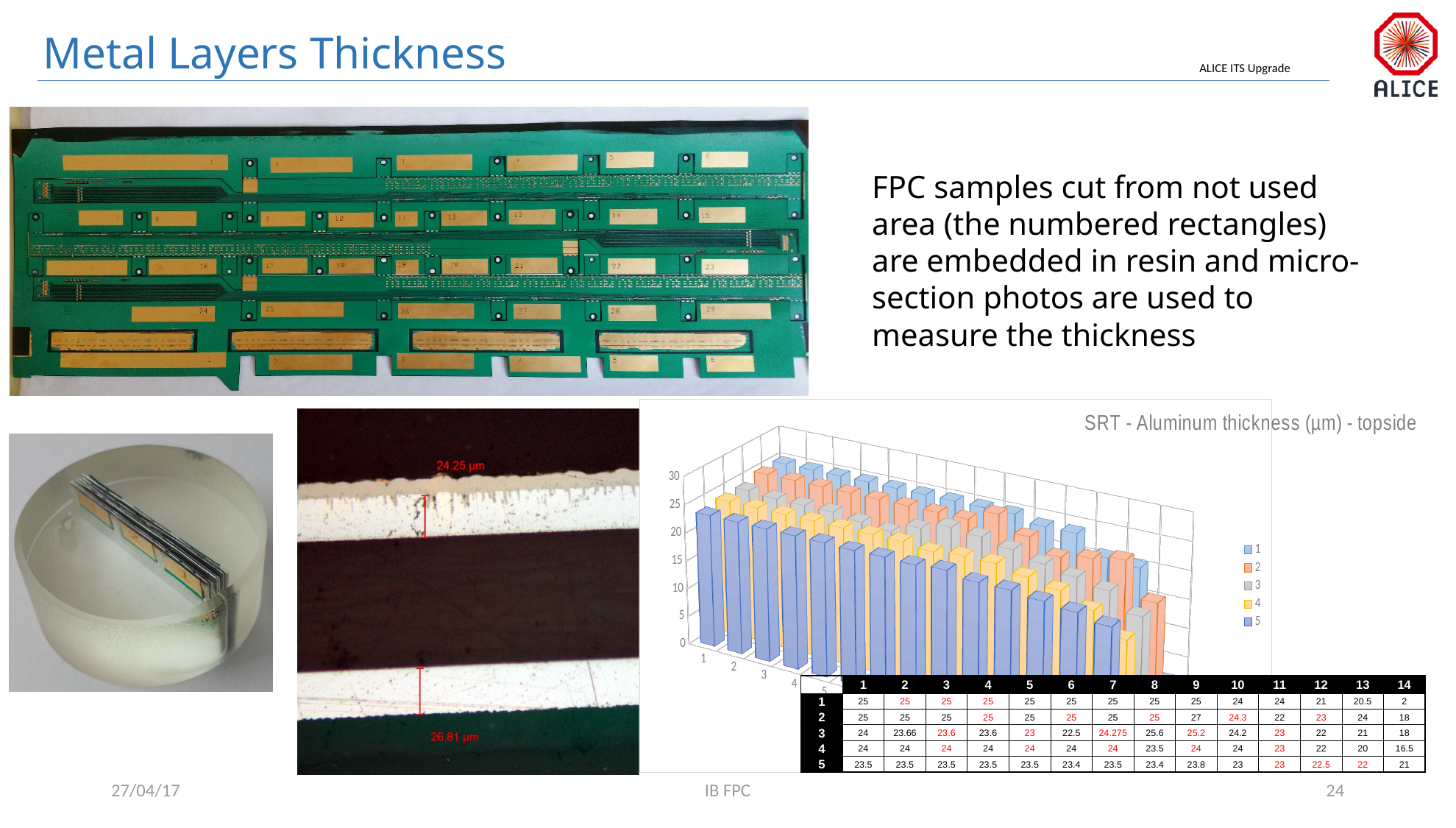
What is the value for series 1 at category 14? 2 How many categories are plotted along the x axis of the chart? 14 What is the title of the chart? SRT - Aluminum thickness (µm) - topside What kind of chart is shown on the slide? bar chart What is the difference between the value for series 1 at category 1 and at category 14? 23 In series 3, which is larger: the value at category 8 or at category 6? category 8 What is the value for series 4 at category 14? 16.5 How many series does the chart's legend list? 5 What is the value for series 2 at category 9? 27 What is the value for series 3 at category 7? 24.275 In series 1, which category has the lowest value? 14 In series 2, which category has the highest value? 9